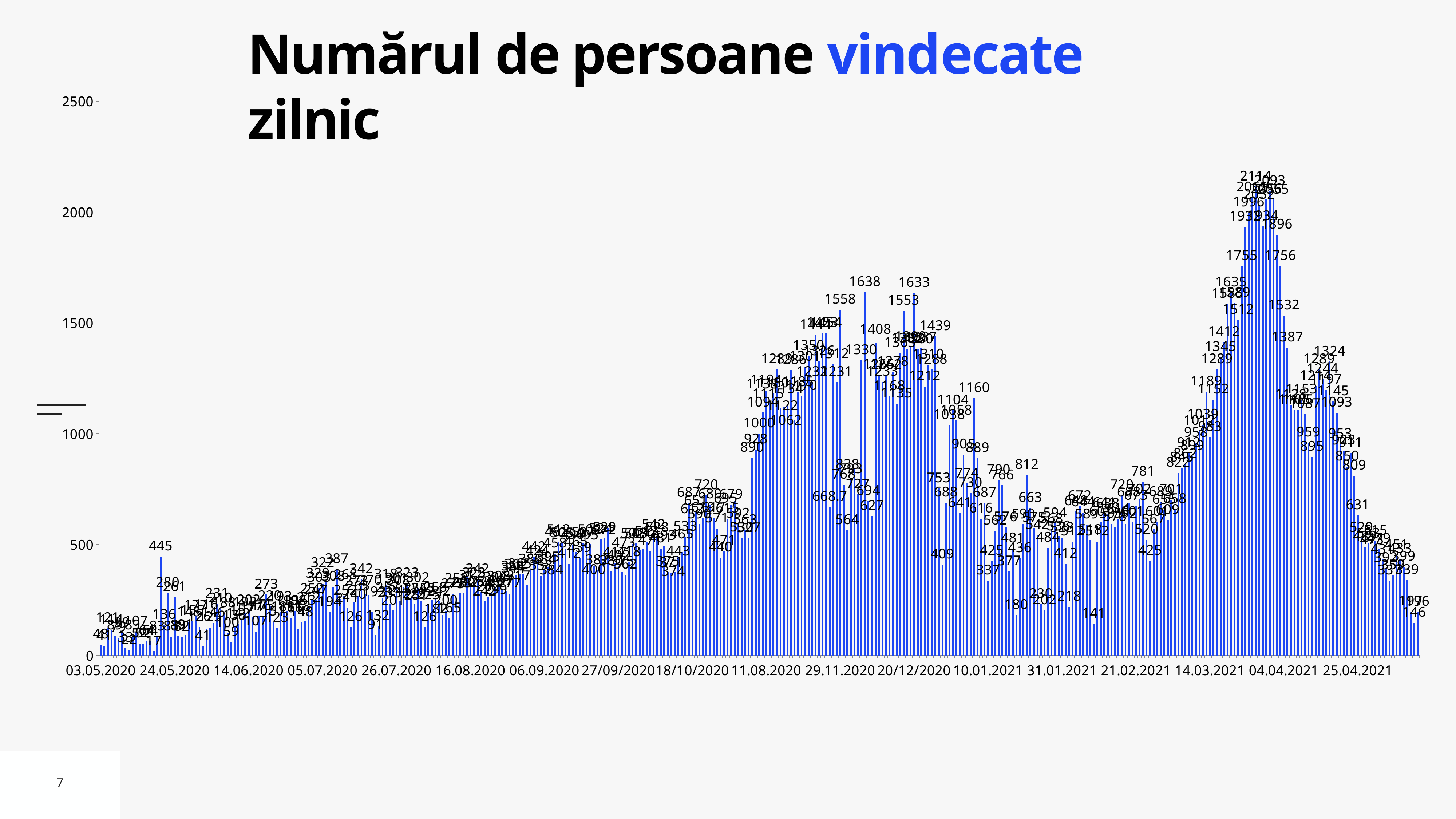
Is the value at the 04.04.2021 tick greater or less than 1500? greater What is the value printed on the tallest bar of the chart? 2114 Do the values generally rise or fall from 04.04.2021 to the end of the chart? fall Is the value for the first bar at 03.05.2020 greater or less than 500? less What kind of chart is shown on the slide? bar chart What value is printed on the tallest bar just before the 29.11.2020 tick? 1558 Which is larger: the spike labelled 812 in January 2021 or the spike labelled 445 in May 2020? 812 What is the highest value shown on the y axis? 2500 What is the difference between the overall peak value (2114) and the late-November 2020 peak (1638)? 476 What is the title of the chart? Numărul de persoane vindecate zilnic Is the value at the 31.01.2021 tick greater or less than 1000? less What value is printed on the isolated spike just before the 24.05.2020 tick? 445